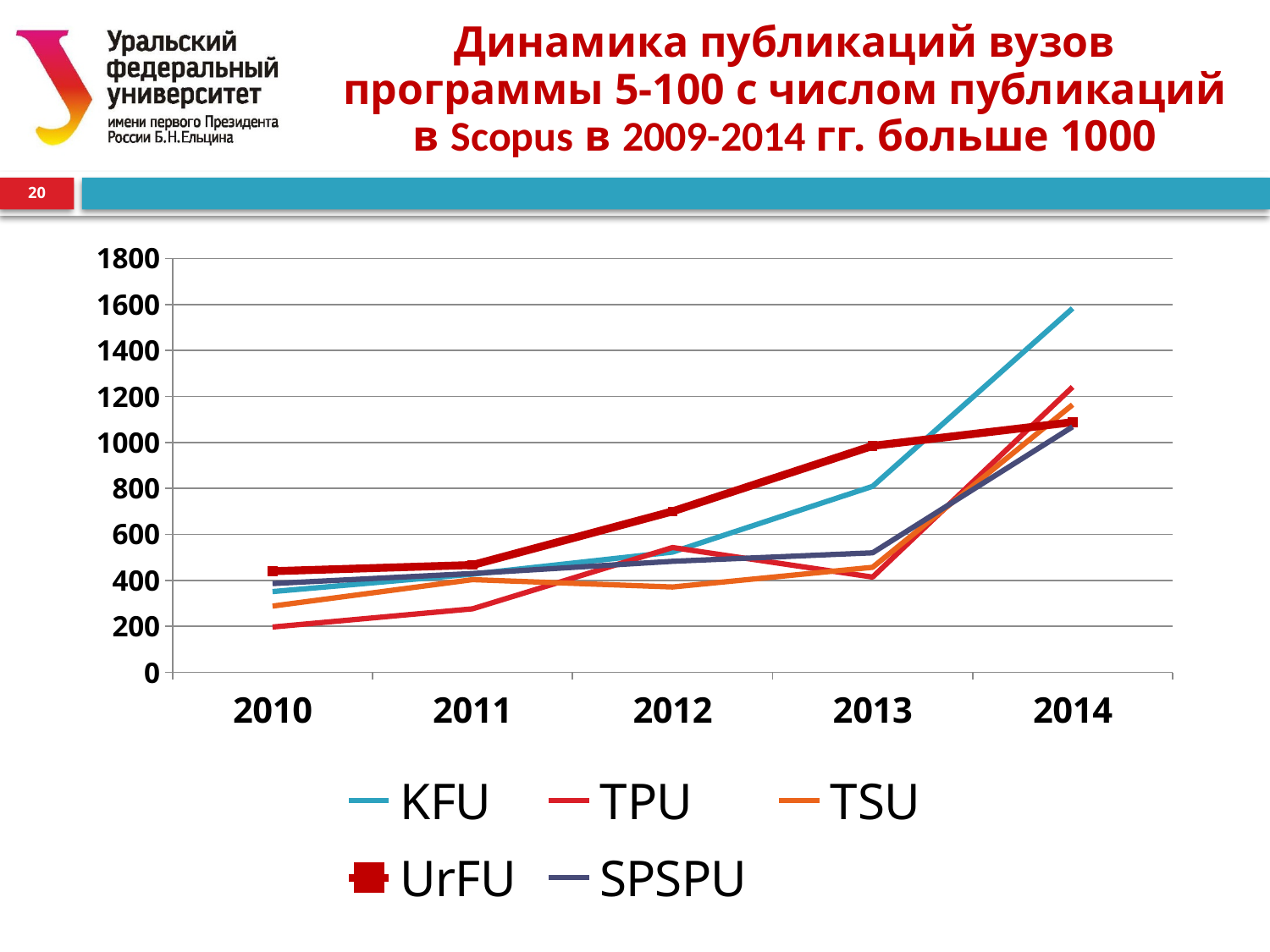
Is the value for SPSPU in 2013 greater or less than 600? less Which university has the highest value in 2014? KFU Which university has the lowest value in 2010? TPU In 2013, which is larger: the value for UrFU or the value for KFU? UrFU Is the value for TPU in 2010 greater or less than 400? less How many series does the legend list? 5 How many years are shown on the x axis? 5 What kind of chart is shown on the slide? line chart Is the value for KFU in 2014 greater or less than 1400? greater Does the KFU line rise or fall from 2010 to 2014? rise Which university has the highest value in 2013? UrFU